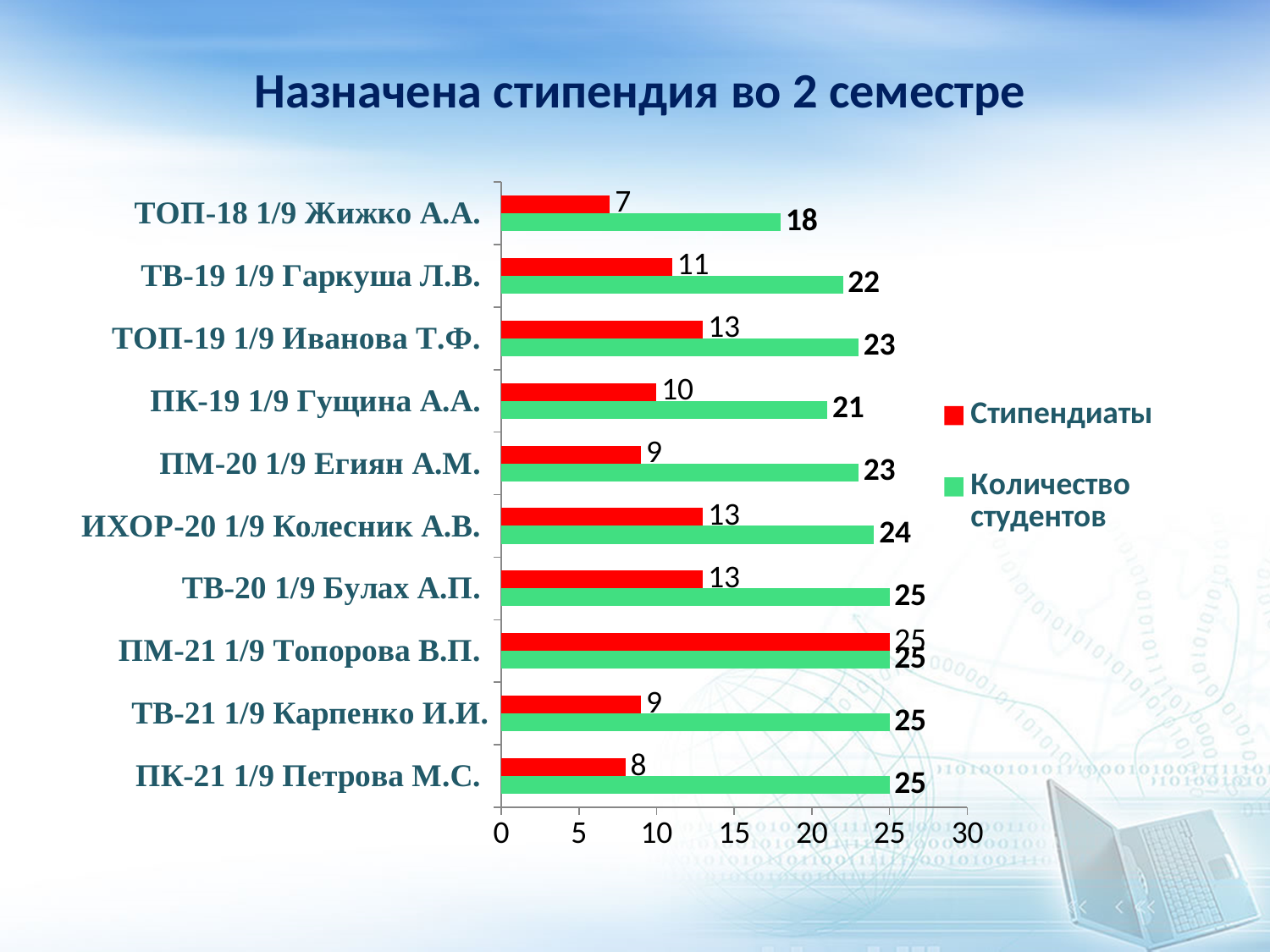
What is the value of Стипендиаты for ТВ-19 1/9 Гаркуша Л.В.? 11 Which is larger: Стипендиаты for ТОП-19 1/9 Иванова Т.Ф. or Стипендиаты for ПМ-20 1/9 Егиян А.М.? ТОП-19 1/9 Иванова Т.Ф. What is the title of the chart? Назначена стипендия во 2 семестре What is the value of Количество студентов for ПК-19 1/9 Гущина А.А.? 21 What is the value of Стипендиаты for ПК-21 1/9 Петрова М.С.? 8 Which group has the lowest value of Количество студентов? ТОП-18 1/9 Жижко А.А. Which group has the lowest value of Стипендиаты? ТОП-18 1/9 Жижко А.А. How many series does the legend list? 2 What is the difference between Количество студентов and Стипендиаты for ИХОР-20 1/9 Колесник А.В.? 11 How many groups (categories) are shown on the chart? 10 Which group has the highest value of Стипендиаты? ПМ-21 1/9 Топорова В.П. What type of chart is shown on the slide? Bar chart